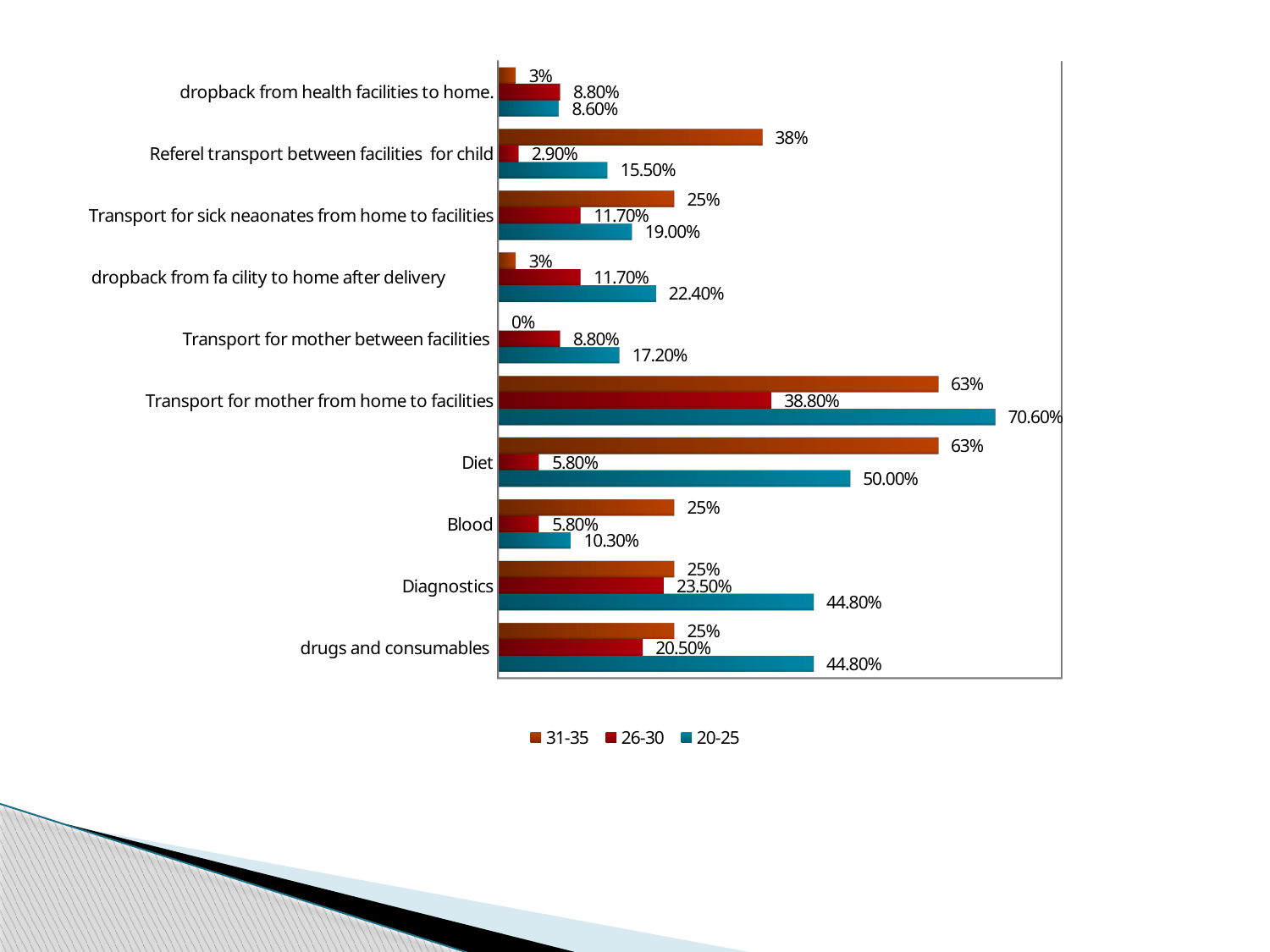
Which category has the lowest value in the 31-35 series? Transport for mother between facilities What is the value for Referel transport between facilities for child in the 31-35 series? 38% Which series is shown in teal/blue according to the legend? 20-25 What is the value for Diagnostics in the 26-30 series? 23.50% What is the difference between the 20-25 and 26-30 values for Diet? 44.20% What is the value for Diet in the 20-25 series? 50.00% How many categories are shown on the chart? 10 What type of chart is shown on the slide? Bar chart How many series does the legend list? 3 What is the value for Transport for mother from home to facilities in the 20-25 series? 70.60% For Blood, which series has the larger value: 31-35 or 20-25? 31-35 Which category has the highest value in the 20-25 series? Transport for mother from home to facilities